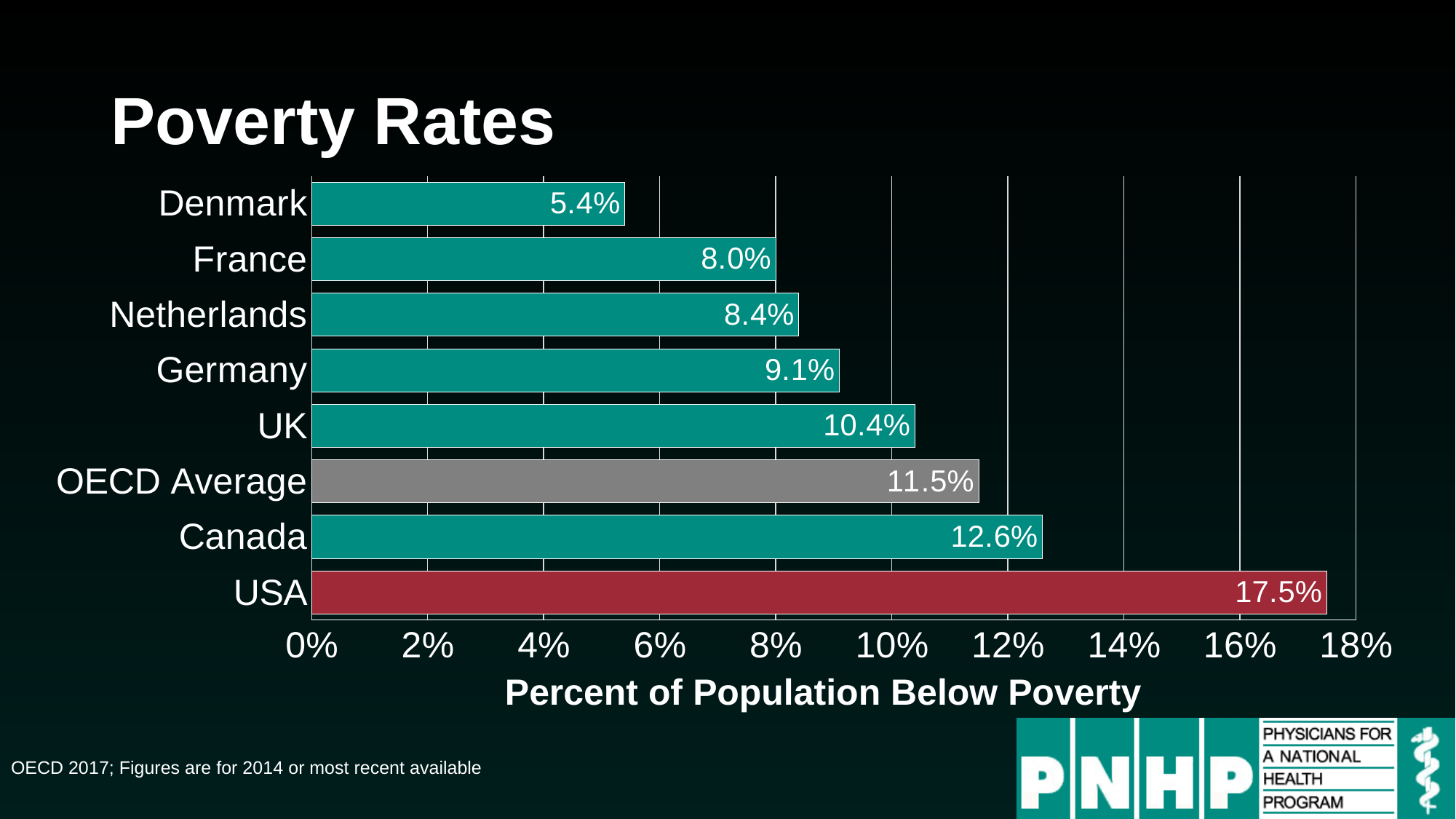
What is the title of the chart? Poverty Rates What is the poverty rate shown for the USA? 17.5% What is the poverty rate shown for Denmark? 5.4% Which country has the lowest poverty rate on the chart? Denmark Is the value for the UK greater or less than 10%? greater What kind of chart is shown on the slide? Bar chart What value is shown for the OECD Average? 11.5% How many bars are shown on the chart? 8 Which country has the highest poverty rate on the chart? USA What is the label on the horizontal axis? Percent of Population Below Poverty Which has a higher poverty rate, Germany or the Netherlands? Germany What is the difference between the poverty rates of the USA and Canada? 4.9%